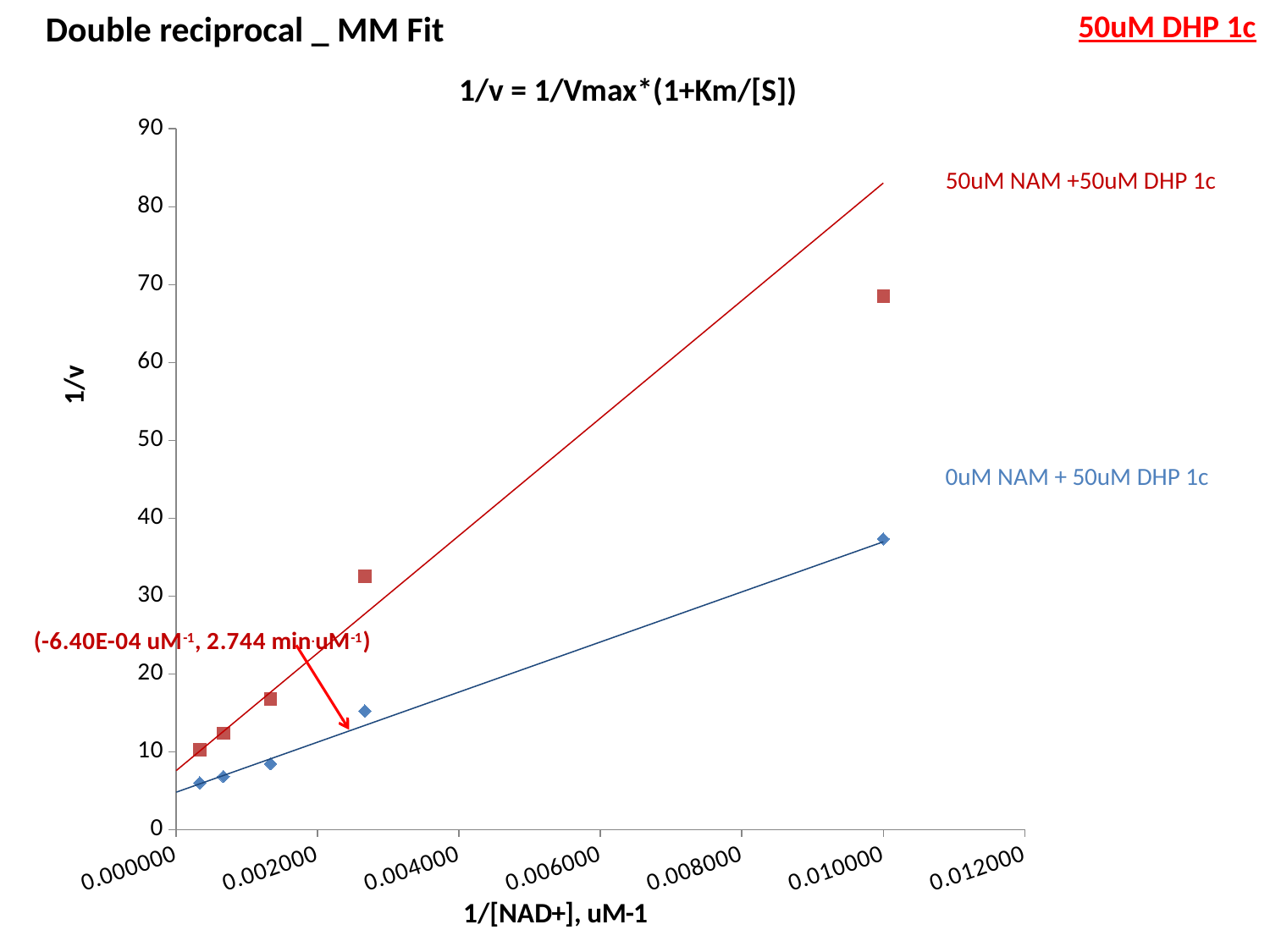
How many data points are plotted for the 50uM NAM +50uM DHP 1c series? 5 Is the 1/v value of the 50uM NAM +50uM DHP 1c point at 1/[NAD+] of about 0.010000 greater or less than 60? greater What kind of chart is shown on the slide? Scatter chart How many data points are plotted for the 0uM NAM + 50uM DHP 1c series? 5 Is the 1/v value of the 0uM NAM + 50uM DHP 1c point at 1/[NAD+] of about 0.010000 greater or less than 40? less What is the title of the chart? 1/v = 1/Vmax*(1+Km/[S]) Do the 1/v values rise or fall as 1/[NAD+] increases along the x axis? Rise Which series has the steeper fitted line? 50uM NAM +50uM DHP 1c At the highest plotted 1/[NAD+] value, which series has the larger 1/v: 50uM NAM +50uM DHP 1c or 0uM NAM + 50uM DHP 1c? 50uM NAM +50uM DHP 1c What is the label of the x axis? 1/[NAD+], uM-1 Is the 1/v value of the 0uM NAM + 50uM DHP 1c point near 1/[NAD+] of 0.002700 greater or less than 20? less How many data series are plotted on the chart? 2